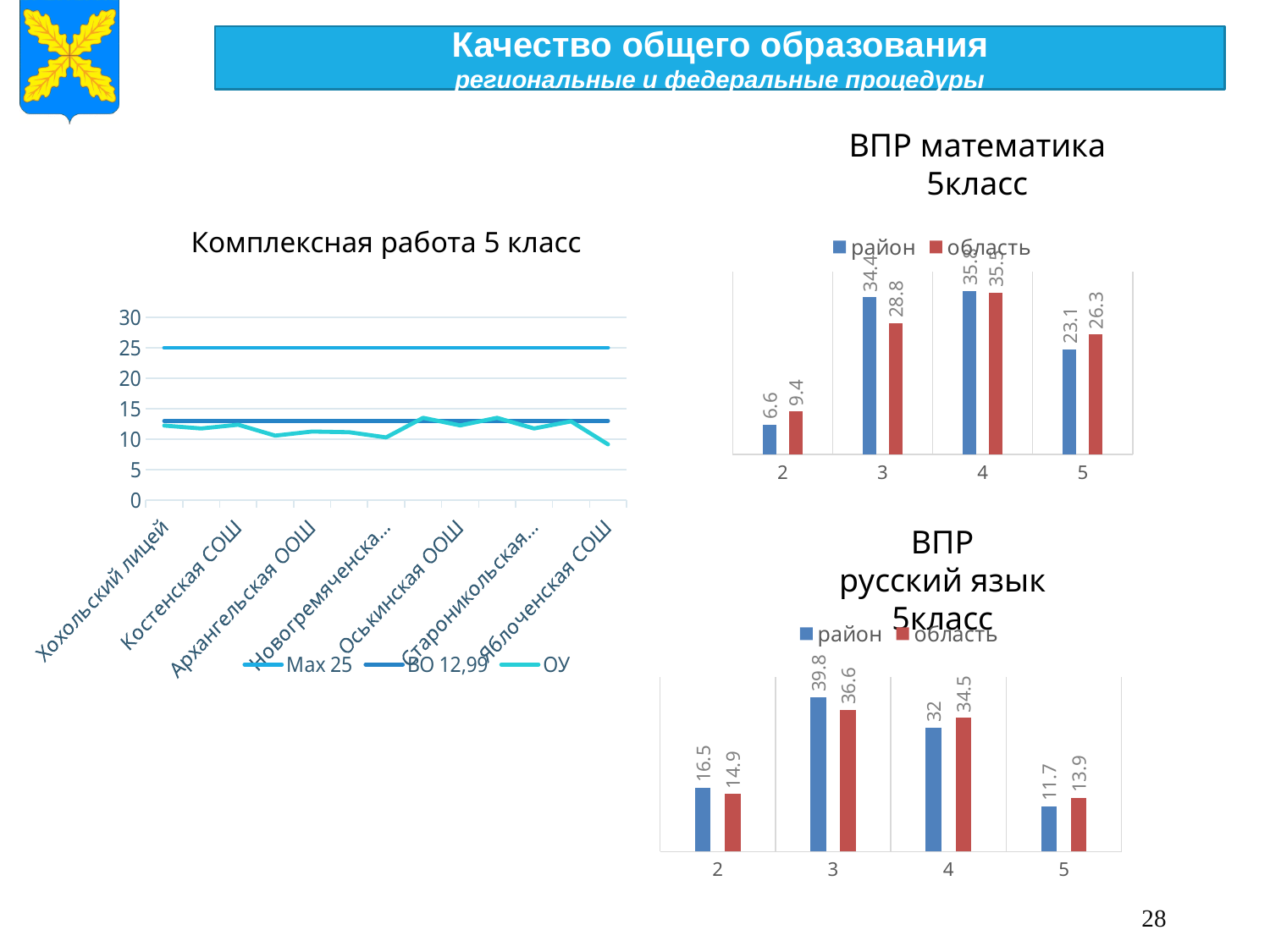
In the 'ВПР русский язык 5класс' chart, which category has the highest область value? 3 In the 'Комплексная работа 5 класс' chart, is the ОУ value for Хохольский лицей greater or less than 10? greater In the 'ВПР математика 5класс' chart, what is the value for район for category 3? 34.4 In the 'ВПР русский язык 5класс' chart, how many series does the legend list? 2 What kind of chart is 'Комплексная работа 5 класс'? line chart In the 'ВПР математика 5класс' chart, what is the difference between область and район for category 2? 2.8 In the 'ВПР русский язык 5класс' chart, what is the difference between район and область for category 3? 3.2 In the 'ВПР русский язык 5класс' chart, what is the value for район for category 4? 32 In the 'ВПР математика 5класс' chart, which is larger for category 3, район or область? район In the 'ВПР математика 5класс' chart, which category has the lowest район value? 2 In the 'ВПР математика 5класс' chart, what is the value for область for category 5? 26.3 In the 'Комплексная работа 5 класс' chart, how many series does the legend list? 3